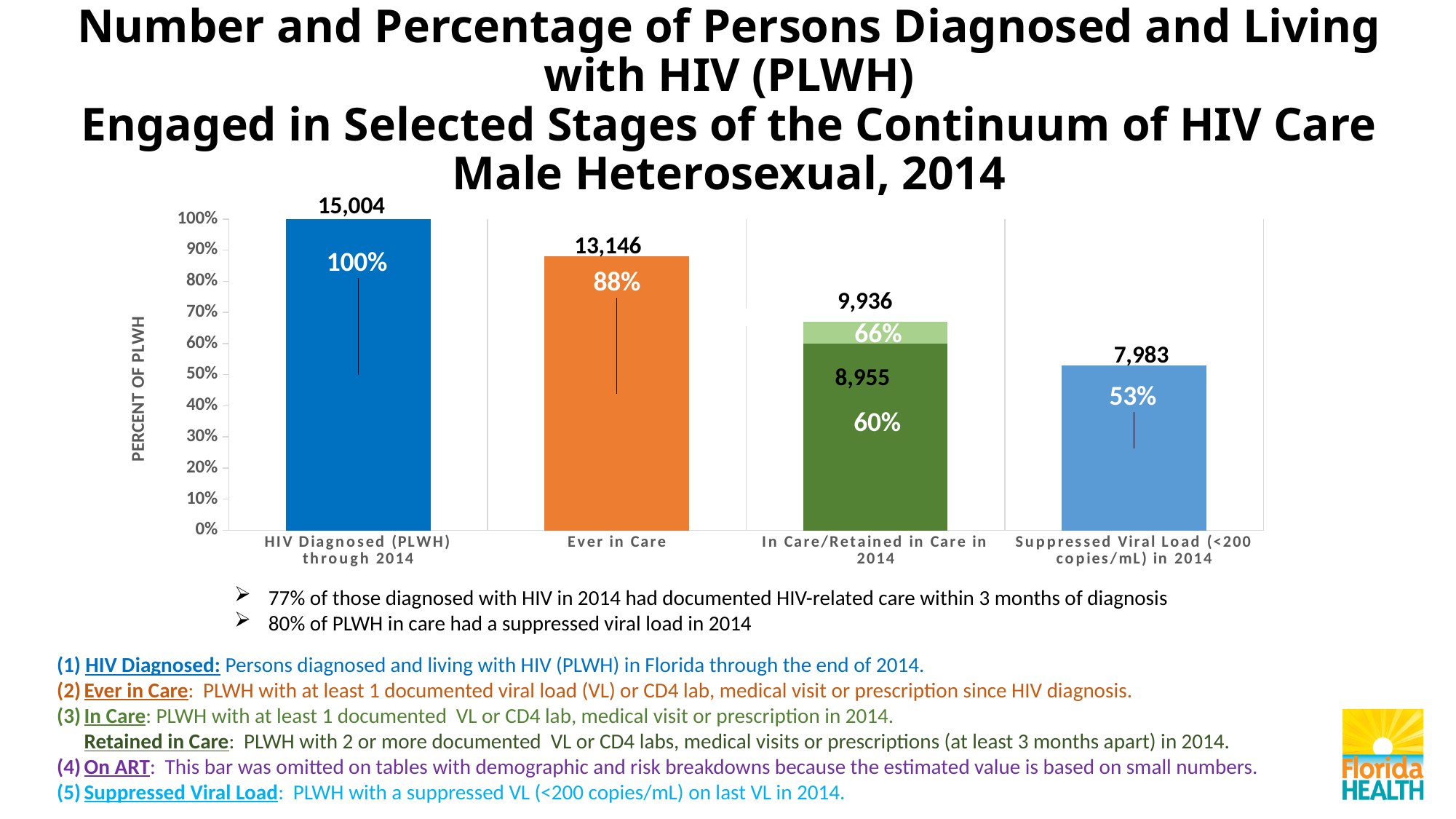
What number is printed above the 'Ever in Care' bar? 13,146 What percentage is shown for the dark green 'Retained in Care' portion of the 'In Care/Retained in Care in 2014' bar? 60% What percentage is shown on the 'Suppressed Viral Load (<200 copies/mL) in 2014' bar? 53% What number is printed at the top of the 'In Care/Retained in Care in 2014' bar? 9,936 What type of chart is shown on the slide? Bar chart How many categories are shown on the x axis? 4 What number is printed above the 'HIV Diagnosed (PLWH) through 2014' bar? 15,004 Which category has the lowest percentage? Suppressed Viral Load (<200 copies/mL) in 2014 What percentage is shown on the 'Ever in Care' bar? 88% What is the difference in percentage points between 'Ever in Care' and 'Suppressed Viral Load (<200 copies/mL) in 2014'? 35 Which category has the highest percentage? HIV Diagnosed (PLWH) through 2014 What number is printed above the 'Suppressed Viral Load (<200 copies/mL) in 2014' bar? 7,983